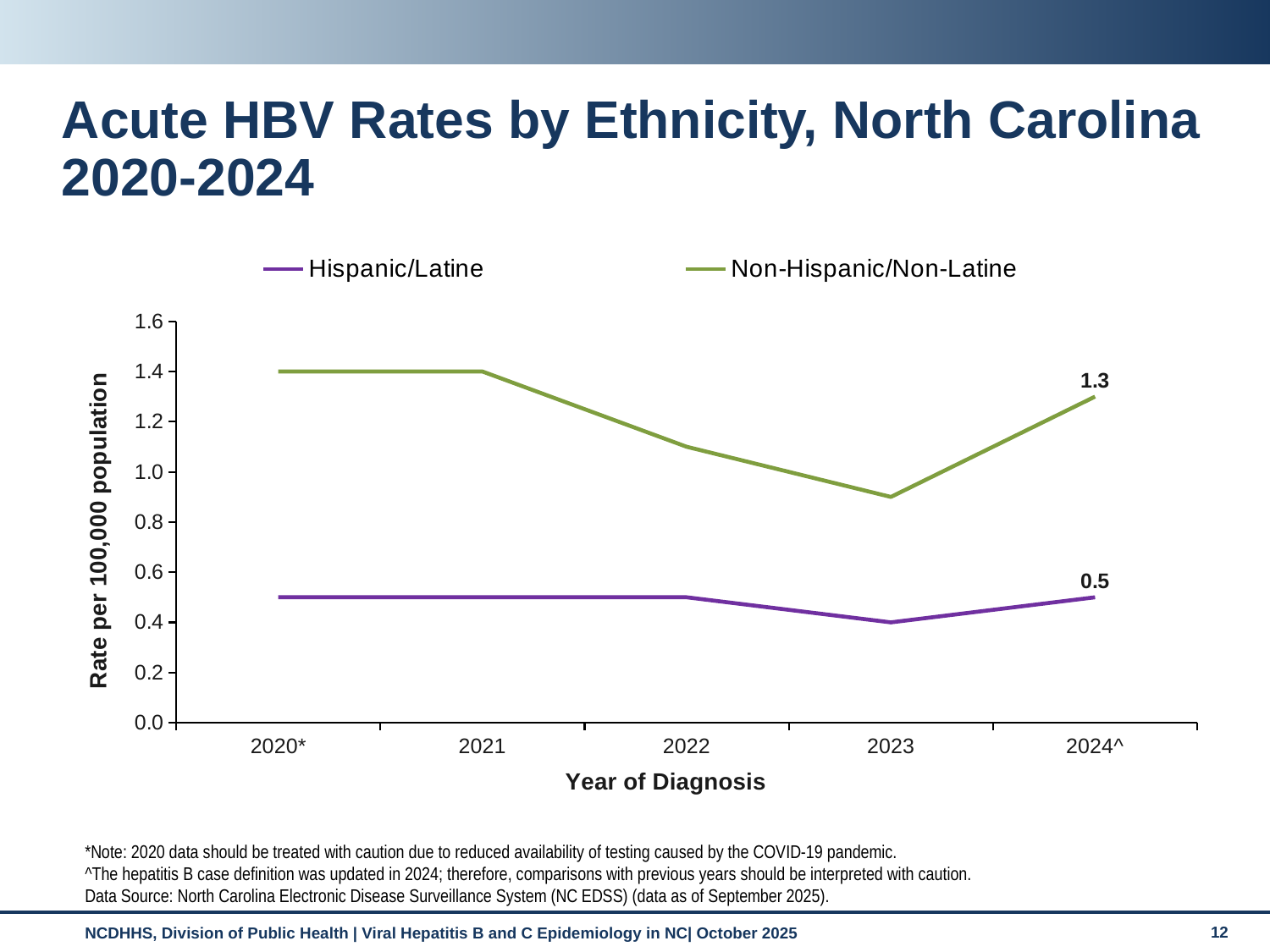
Which ethnicity group has the higher acute HBV rate in 2024^? Non-Hispanic/Non-Latine Is the Non-Hispanic/Non-Latine rate in 2022 greater or less than 1.0? greater What kind of chart is shown on the slide? Line chart How many series does the legend list? 2 In which year is the Non-Hispanic/Non-Latine rate lowest? 2023 In which year is the Hispanic/Latine rate lowest? 2023 What is the acute HBV rate for Non-Hispanic/Non-Latine in 2024^? 1.3 What is the difference between the Non-Hispanic/Non-Latine and Hispanic/Latine rates in 2024^? 0.8 Is the Non-Hispanic/Non-Latine rate in 2023 greater or less than 1.0? less What is the acute HBV rate for Hispanic/Latine in 2024^? 0.5 What is the label of the y axis? Rate per 100,000 population How many years are shown on the x axis? 5